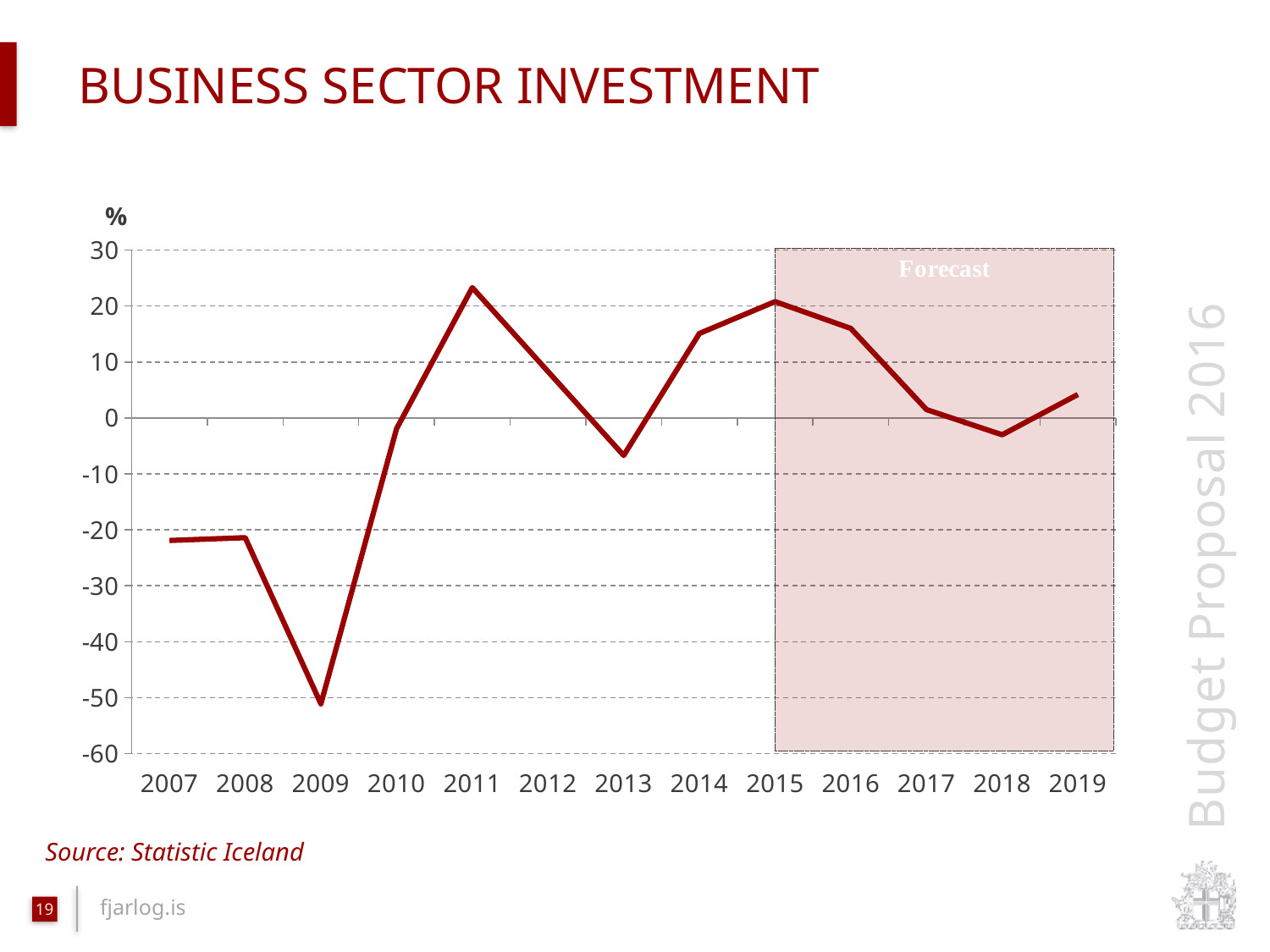
In which year does the line reach its highest value? 2011 Is the value for 2009 greater or less than -40? less What kind of chart is shown on the slide? line chart Is the value for 2011 greater or less than 20? greater What is the title of the slide? BUSINESS SECTOR INVESTMENT Does the line rise or fall from 2007 to 2009? fall In which year is business sector investment at its lowest? 2009 Which years are covered by the shaded 'Forecast' area? 2015 to 2019 Which year has the larger value, 2011 or 2013? 2011 Is the value for 2014 greater or less than 10? greater How many years are shown on the x axis of the chart? 13